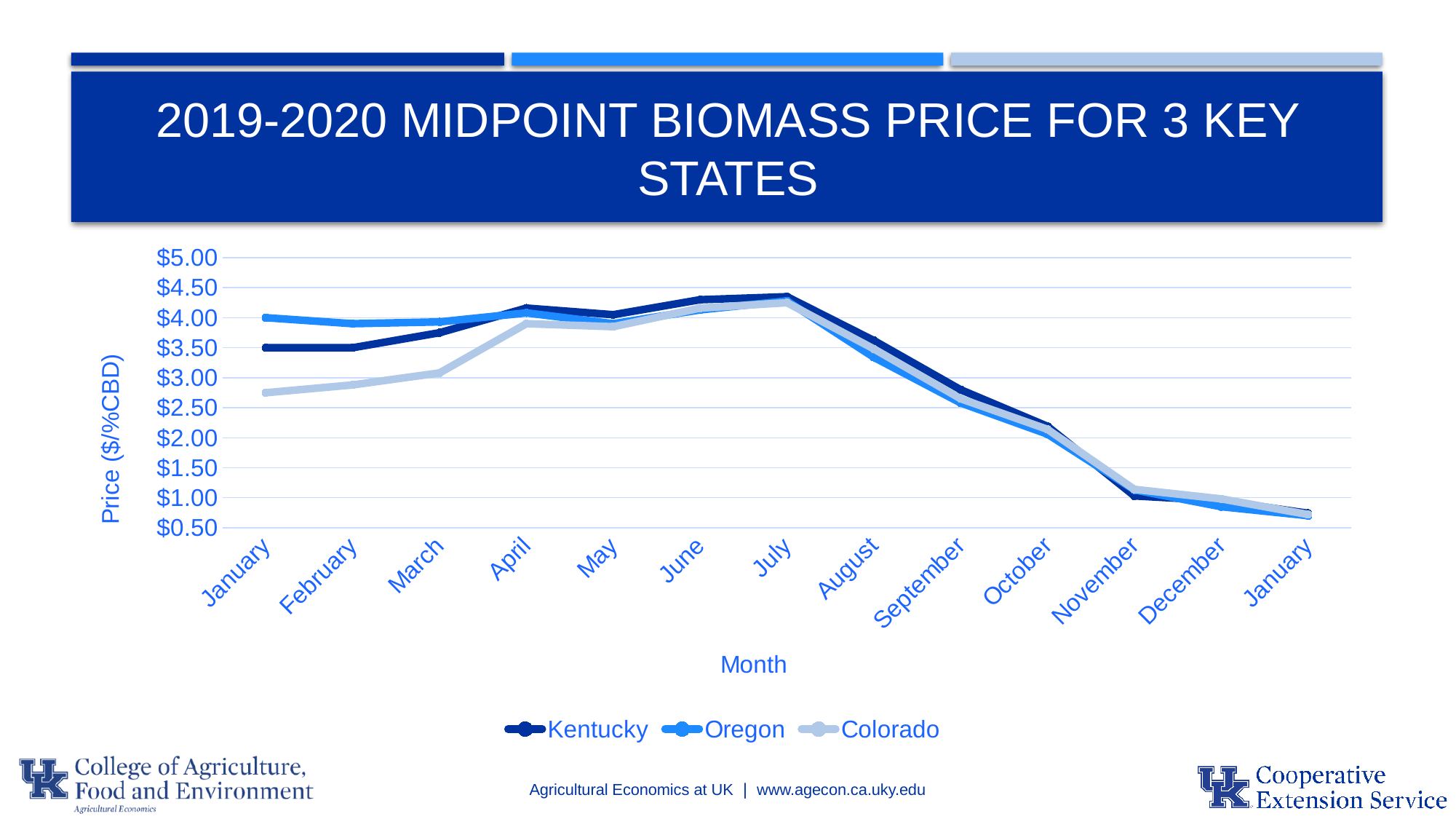
Which state has the lowest price in the first January? Colorado How many series does the legend list? 3 What kind of chart is shown on the slide? line chart Which state has the highest price in the first January? Oregon In February, which is larger, the Oregon price or the Kentucky price? Oregon What is the Oregon price in the first January? $4.00 Is the Kentucky price in September greater or less than $3.00? less How many months are plotted along the x axis? 13 Is the Colorado price in the first January greater or less than $3.00? less Is the Kentucky price in July greater or less than $4.00? greater What is the Kentucky price in the first January? $3.50 Do the prices rise or fall from July to the final January? fall